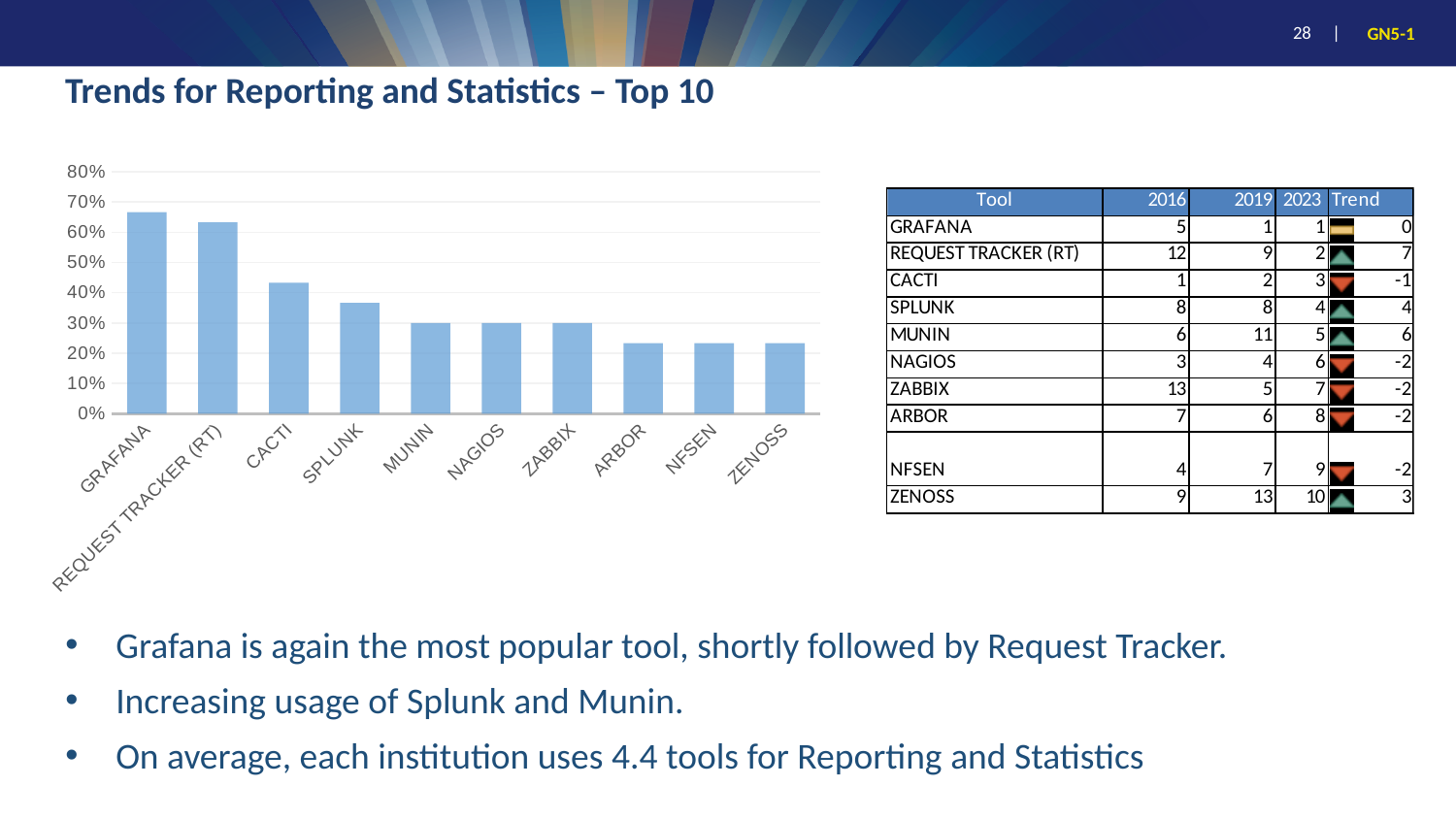
What is the title of the slide containing the chart? Trends for Reporting and Statistics – Top 10 Is the value for ARBOR greater or less than 30%? less Is the value for GRAFANA greater or less than 60%? greater What kind of chart is shown on the slide? bar chart Is the value for MUNIN greater or less than 20%? greater Do the bar values generally rise or fall from left to right along the x axis? fall Which tool has the highest bar in the chart? GRAFANA Which has the larger value, CACTI or SPLUNK? CACTI How many tools are plotted in the bar chart? 10 Which has the larger value, GRAFANA or CACTI? GRAFANA